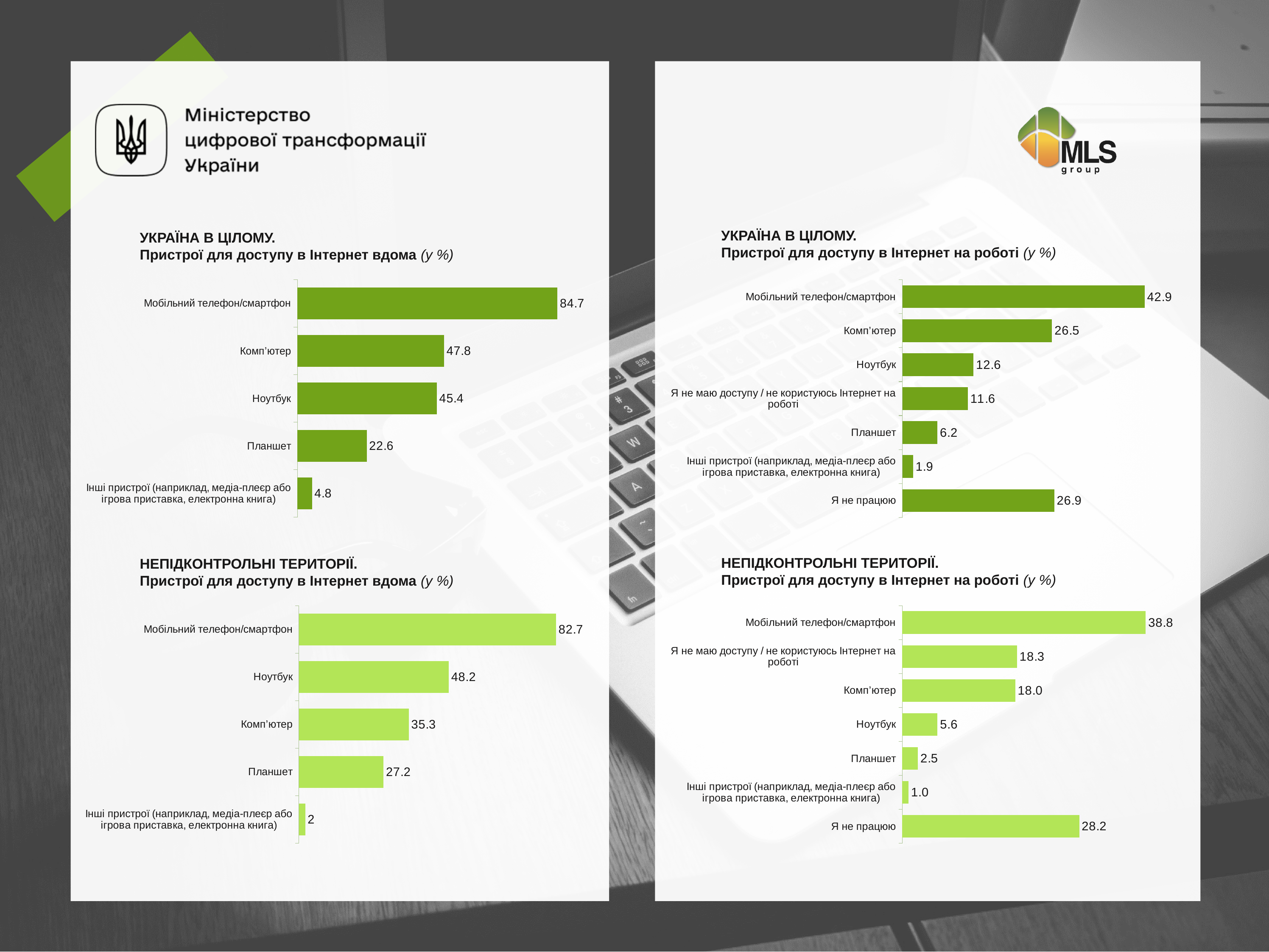
In the top-right chart (Україна в цілому, на роботі), which is larger: Ноутбук or Планшет? Ноутбук In the top-right chart (Україна в цілому, на роботі), what is the value for Я не працюю? 26.9 In the top-left chart (Україна в цілому, вдома), what is the difference between Комп’ютер and Ноутбук? 2.4 In the bottom-right chart (Непідконтрольні території, на роботі), which category has the lowest value? Інші пристрої (наприклад, медіа-плеєр або ігрова приставка, електронна книга) In the bottom-right chart (Непідконтрольні території, на роботі), what is the value for Я не маю доступу / не користуюсь Інтернет на роботі? 18.3 In the bottom-left chart (Непідконтрольні території, вдома), what is the value for Ноутбук? 48.2 In the top-left chart (Україна в цілому, вдома), what is the value for Мобільний телефон/смартфон? 84.7 In the top-right chart (Україна в цілому, на роботі), how many categories are shown? 7 In the top-left chart (Україна в цілому, вдома), which category has the lowest value? Інші пристрої (наприклад, медіа-плеєр або ігрова приставка, електронна книга) In the top-right chart (Україна в цілому, на роботі), which category has the highest value? Мобільний телефон/смартфон In the bottom-left chart (Непідконтрольні території, вдома), what is the difference between Мобільний телефон/смартфон and Ноутбук? 34.5 What type of chart is the bottom-left chart (Непідконтрольні території, вдома)? Bar chart